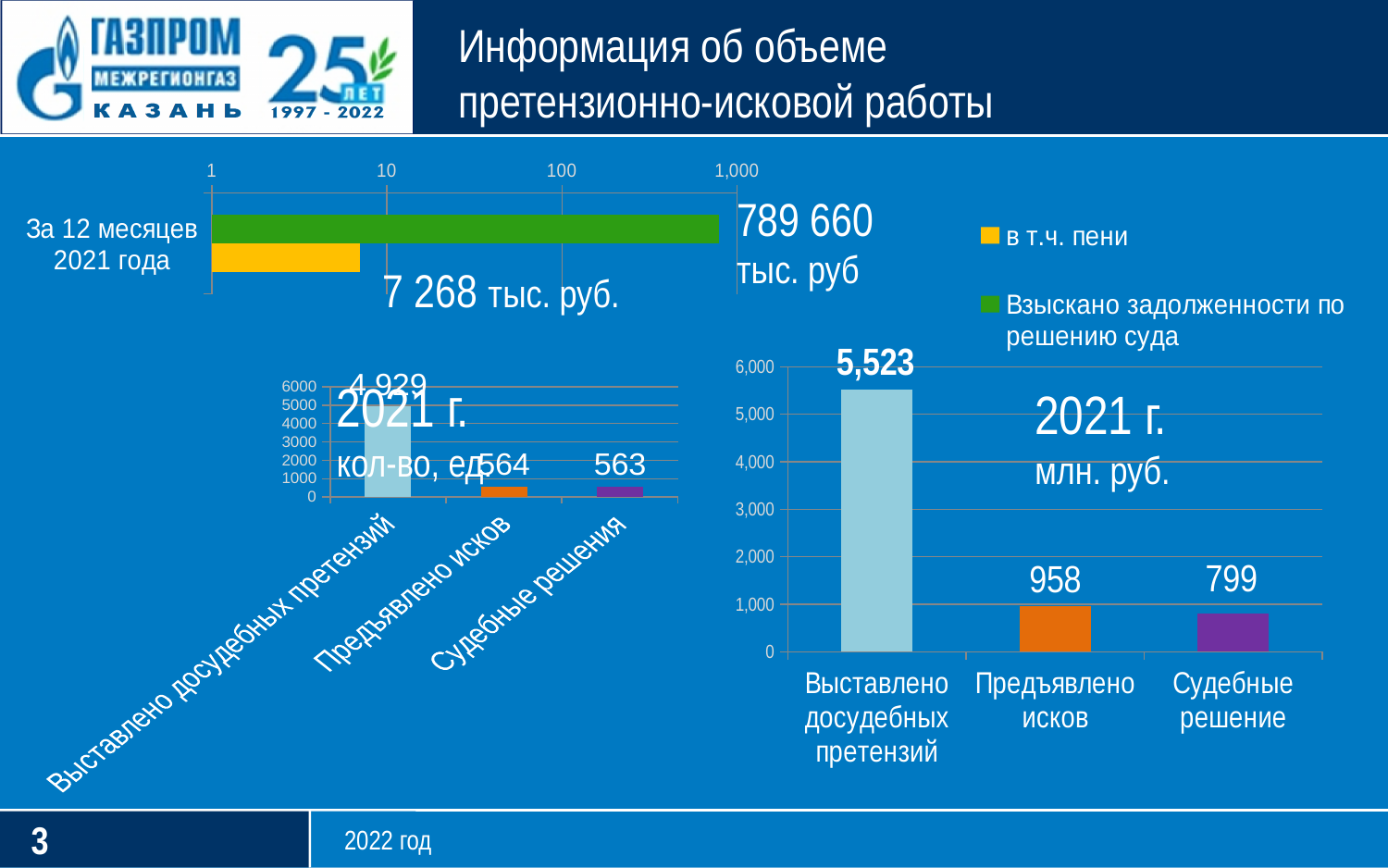
In the top horizontal bar chart, what value is labelled for the green bar (Взыскано задолженности по решению суда)? 789 660 тыс. руб In the right-hand chart '2021 г. млн. руб.', what is the difference between Предъявлено исков and Судебные решение? 159 In the right-hand chart '2021 г. млн. руб.', what is the value for Выставлено досудебных претензий? 5,523 In the right-hand chart '2021 г. млн. руб.', which category has the lowest value? Судебные решение In the right-hand chart '2021 г. млн. руб.', what is the value for Судебные решение? 799 In the small left chart '2021 г. кол-во, ед.', what is the value for Предъявлено исков? 564 In the top horizontal bar chart, which series has the larger value: в т.ч. пени or Взыскано задолженности по решению суда? Взыскано задолженности по решению суда What kind of chart is the top chart labelled 'За 12 месяцев 2021 года'? bar chart In the right-hand chart '2021 г. млн. руб.', what is the value for Предъявлено исков? 958 In the top horizontal bar chart, what value is labelled for the yellow bar (в т.ч. пени)? 7 268 тыс. руб. How many series does the legend of the top horizontal bar chart list? 2 How many categories are shown in the small left chart '2021 г. кол-во, ед.'? 3